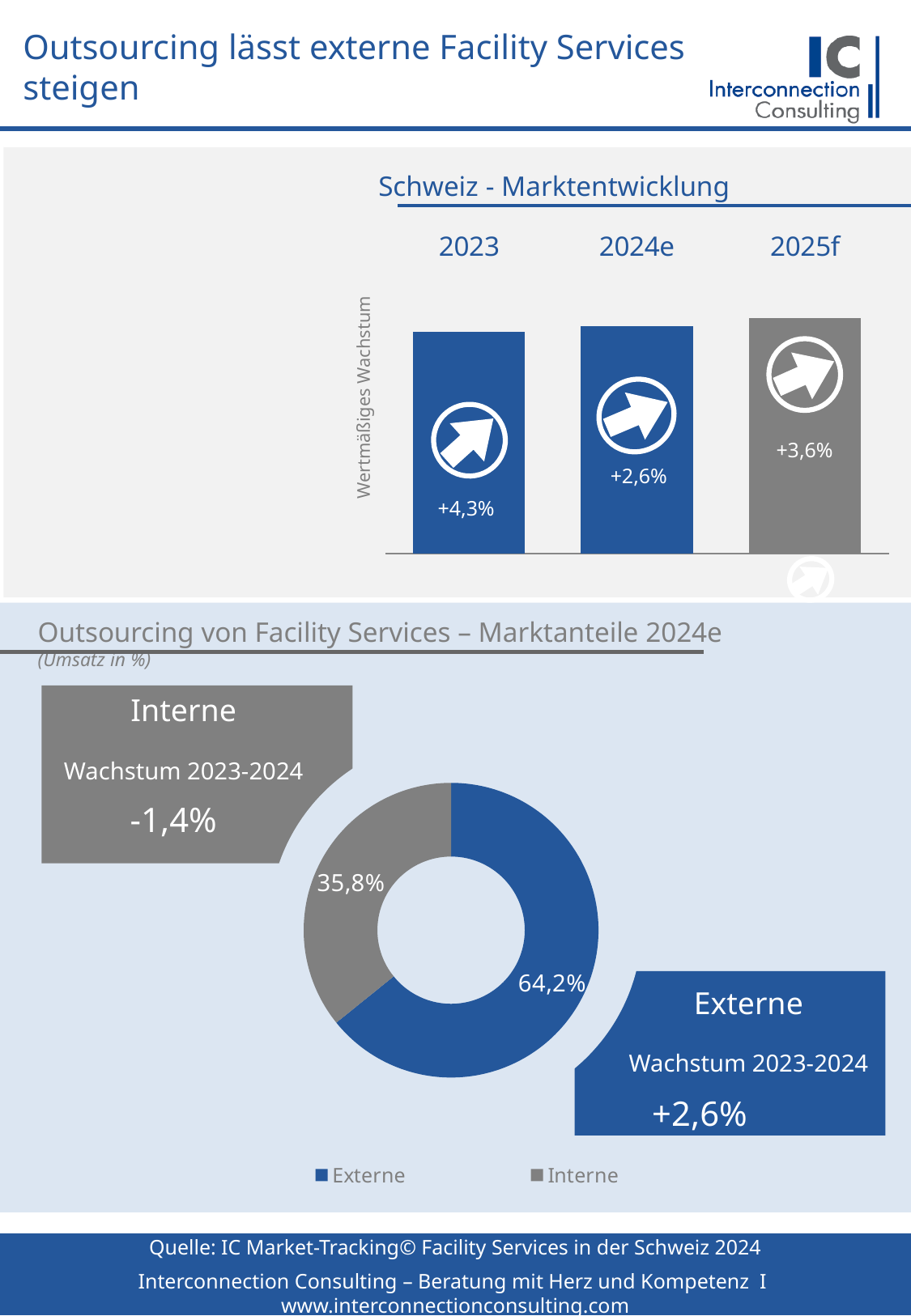
What type of chart is the 'Schweiz - Marktentwicklung' chart? Bar chart In the 'Schweiz - Marktentwicklung' chart, how many years are shown? 3 In the 'Marktanteile 2024e' chart, what share is shown for Externe? 64,2% In the 'Marktanteile 2024e' chart, which segment is larger, Externe or Interne? Externe In the 'Schweiz - Marktentwicklung' chart, what is the difference between the printed growth rates for 2023 and 2024e? 1,7 percentage points What type of chart is the 'Marktanteile 2024e' chart? Donut (pie) chart In the 'Schweiz - Marktentwicklung' chart, what is the growth value shown for 2023? +4,3% In the 'Schweiz - Marktentwicklung' chart, which year has the lowest printed growth rate? 2024e How many entries does the legend of the 'Marktanteile 2024e' chart list? 2 In the 'Schweiz - Marktentwicklung' chart, what is the growth value shown for 2024e? +2,6% In the 'Schweiz - Marktentwicklung' chart, what is the growth value shown for 2025f? +3,6% In the 'Marktanteile 2024e' chart, what share is shown for Interne? 35,8%